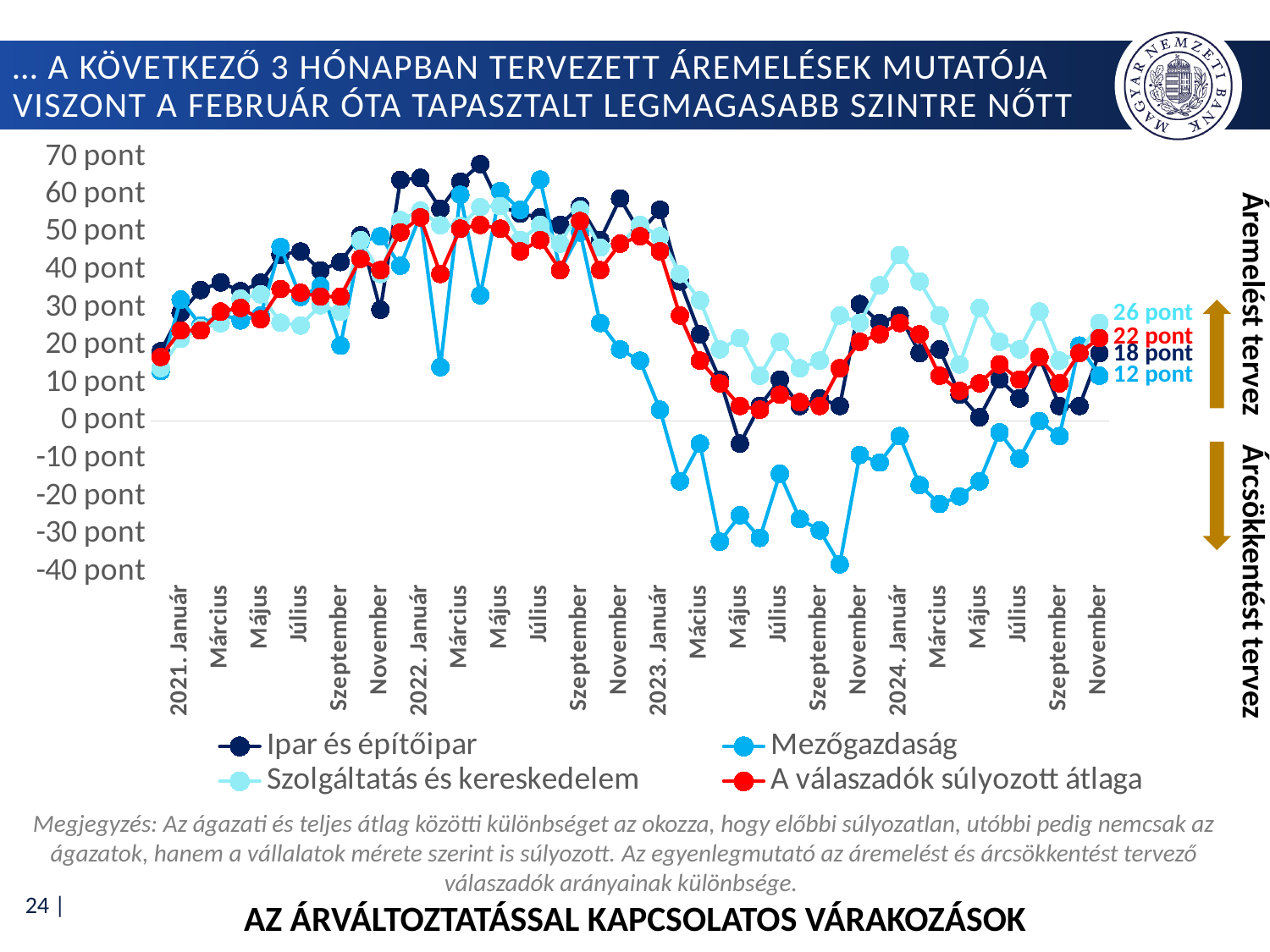
At the end of the chart, which is larger: the value for Ipar és építőipar or for Mezőgazdaság? Ipar és építőipar Which series has the highest value at the end of the chart? Szolgáltatás és kereskedelem What kind of chart is shown on the slide? line chart Is the lowest point of the Mezőgazdaság series (around autumn 2023) greater or less than -30 pont? less Which series has the lowest value at the end of the chart? Mezőgazdaság What is the final value labelled for the Mezőgazdaság series? 12 pont What is the final value labelled for A válaszadók súlyozott átlaga? 22 pont How many series does the legend list? 4 Which series is drawn in red? A válaszadók súlyozott átlaga What is the final value labelled for the Ipar és építőipar series? 18 pont What is the difference between the final labelled values of Szolgáltatás és kereskedelem and Mezőgazdaság? 14 pont